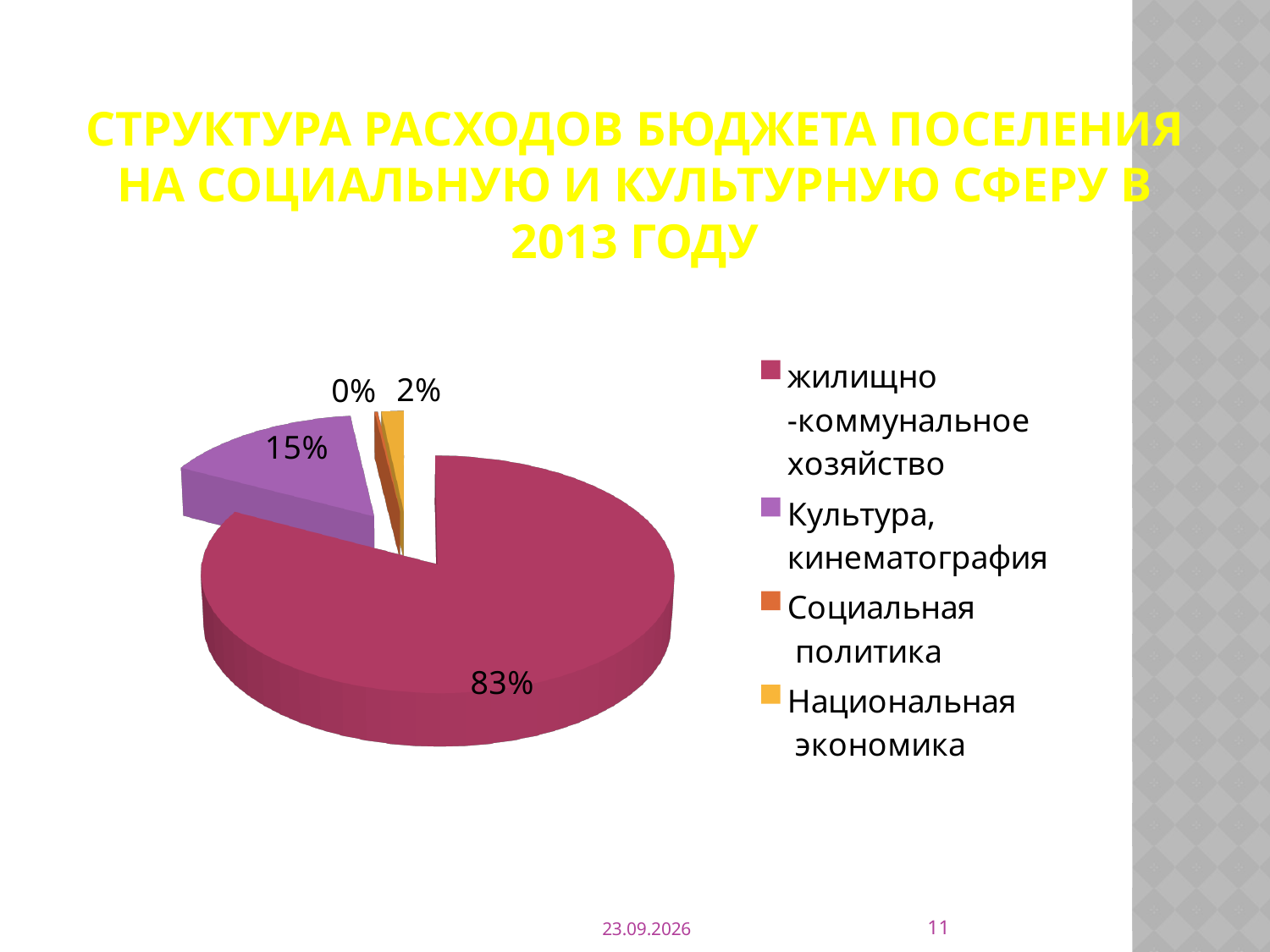
What share of the pie does Культура, кинематография have? 15% What kind of chart is shown on the slide? Pie chart What colour is the slice for Культура, кинематография? Purple What is the difference in percentage points between жилищно-коммунальное хозяйство and Культура, кинематография? 68 Which category has the smallest share of the pie? Социальная политика Which category has the largest share of the pie? жилищно-коммунальное хозяйство What share of the pie does Социальная политика have? 0% Which is larger: the share for Культура, кинематография or the share for Национальная экономика? Культура, кинематография How many categories does the pie chart show? 4 What share of the pie does Национальная экономика have? 2% Which year does the chart title refer to? 2013